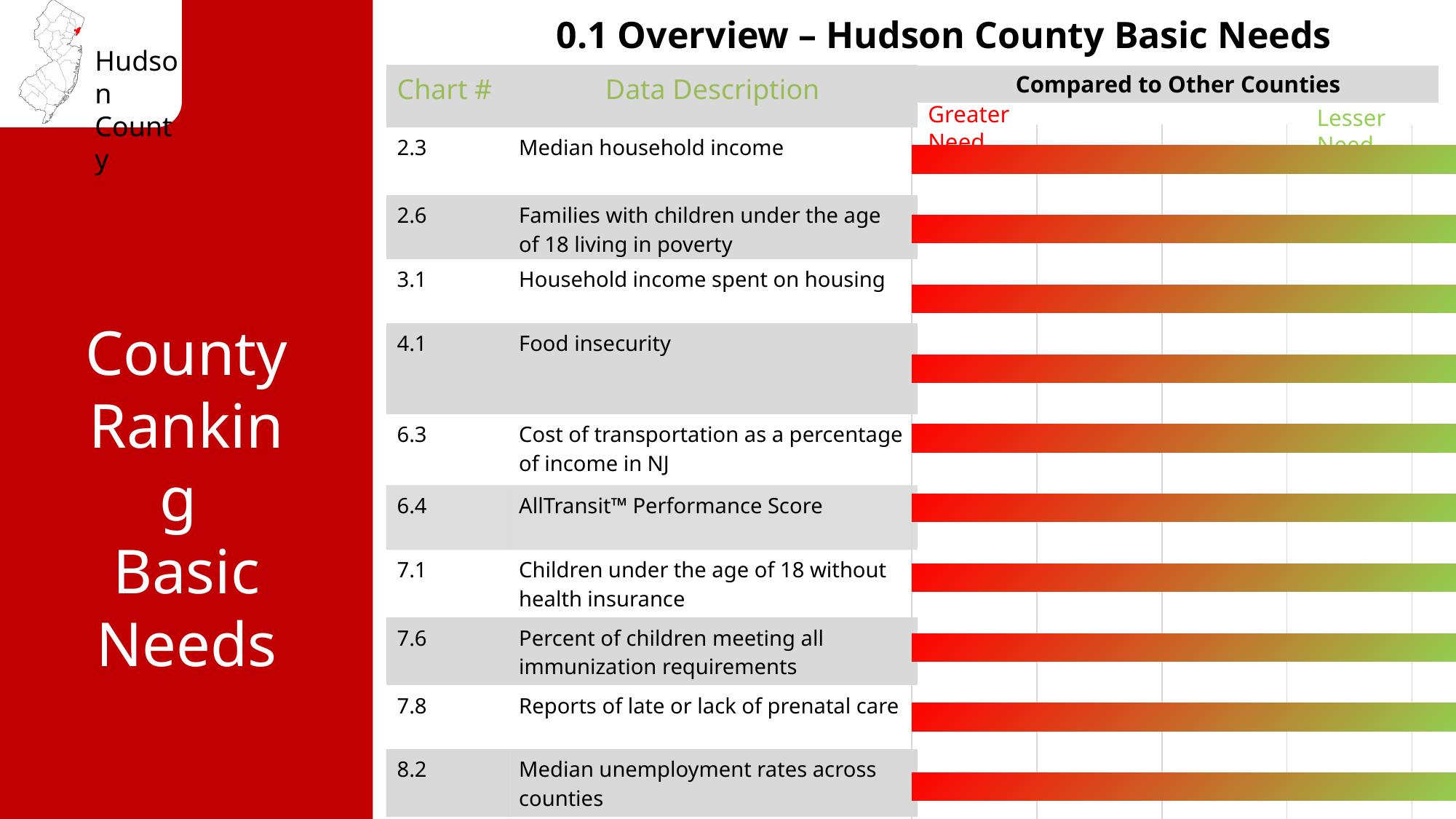
What is the Chart # listed for Food insecurity? 4.1 What does the left end of the Compared to Other Counties scale indicate? Greater Need Which data description is listed for Chart # 7.8? Reports of late or lack of prenatal care What does the right end of the Compared to Other Counties scale indicate? Lesser Need What is the Chart # listed for Median unemployment rates across counties? 8.2 Which data description is listed for Chart # 3.1? Household income spent on housing What kind of chart is used in the Compared to Other Counties section? Bar chart What is the Chart # listed for Median household income? 2.3 Which data description is listed for Chart # 6.4? AllTransit™ Performance Score How many data description rows (bars) are shown in the Compared to Other Counties chart? 10